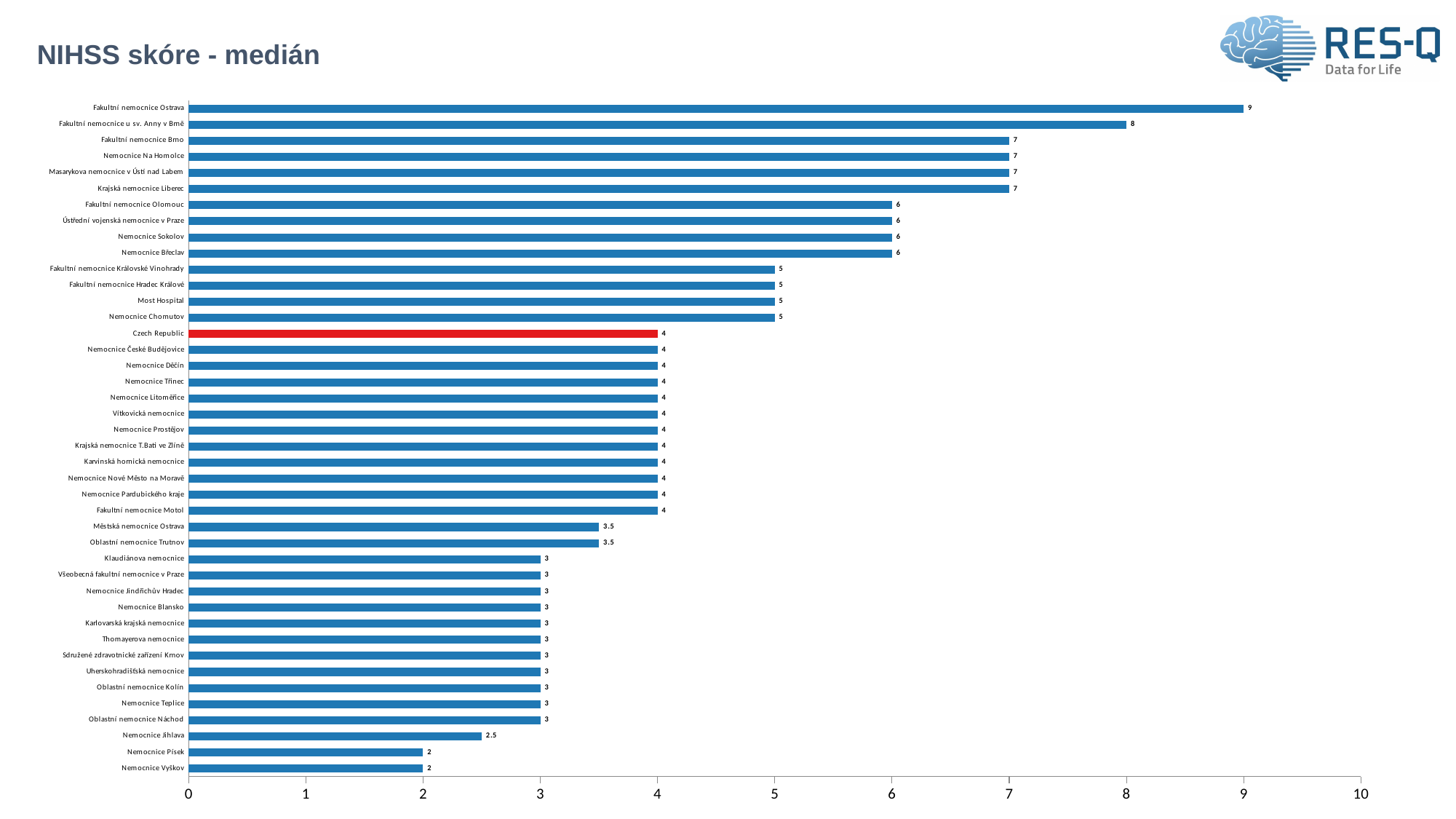
What is the title of the chart? NIHSS skóre - medián Which is larger, the value for Nemocnice Sokolov or the value for Nemocnice Chomutov? Nemocnice Sokolov What is the value shown for Czech Republic? 4 What kind of chart is shown on the slide? bar chart What is the median NIHSS score for Fakultní nemocnice Ostrava? 9 Which bar is coloured red instead of blue? Czech Republic What is the difference between the values for Fakultní nemocnice Brno and Nemocnice Písek? 5 What is the value for Nemocnice Jihlava? 2.5 Which hospital has the highest median NIHSS score? Fakultní nemocnice Ostrava What is the value for Městská nemocnice Ostrava? 3.5 What is the difference between the values for Fakultní nemocnice Ostrava and Fakultní nemocnice u sv. Anny v Brně? 1 Is the value for Fakultní nemocnice u sv. Anny v Brně greater or less than 5? greater